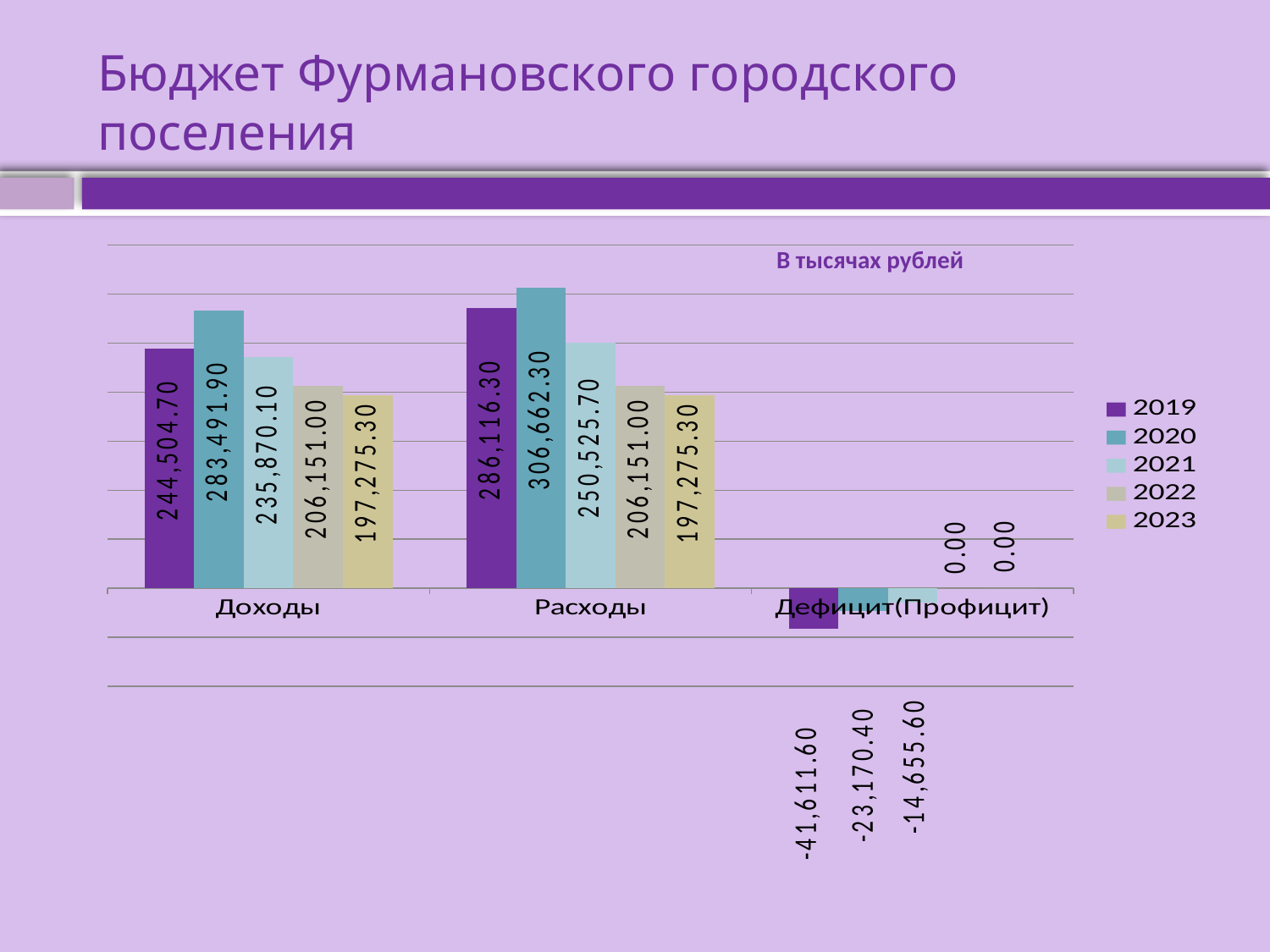
Which is larger, Доходы in 2021 or Доходы in 2022? Доходы in 2021 What is the value for Расходы in 2021? 250,525.70 How many series does the legend list? 5 What is the value for Доходы in 2020? 283,491.90 What unit is stated in the chart's label at the top right? В тысячах рублей Which year has the lowest value for Доходы? 2023 What is the difference between Расходы and Доходы in 2019? 41,611.60 Which year has the highest value for Расходы? 2020 How many categories are shown on the x axis? 3 What is the value for Дефицит(Профицит) in 2023? 0.00 What is the value for Дефицит(Профицит) in 2019? -41,611.60 What kind of chart is shown on the slide? bar chart